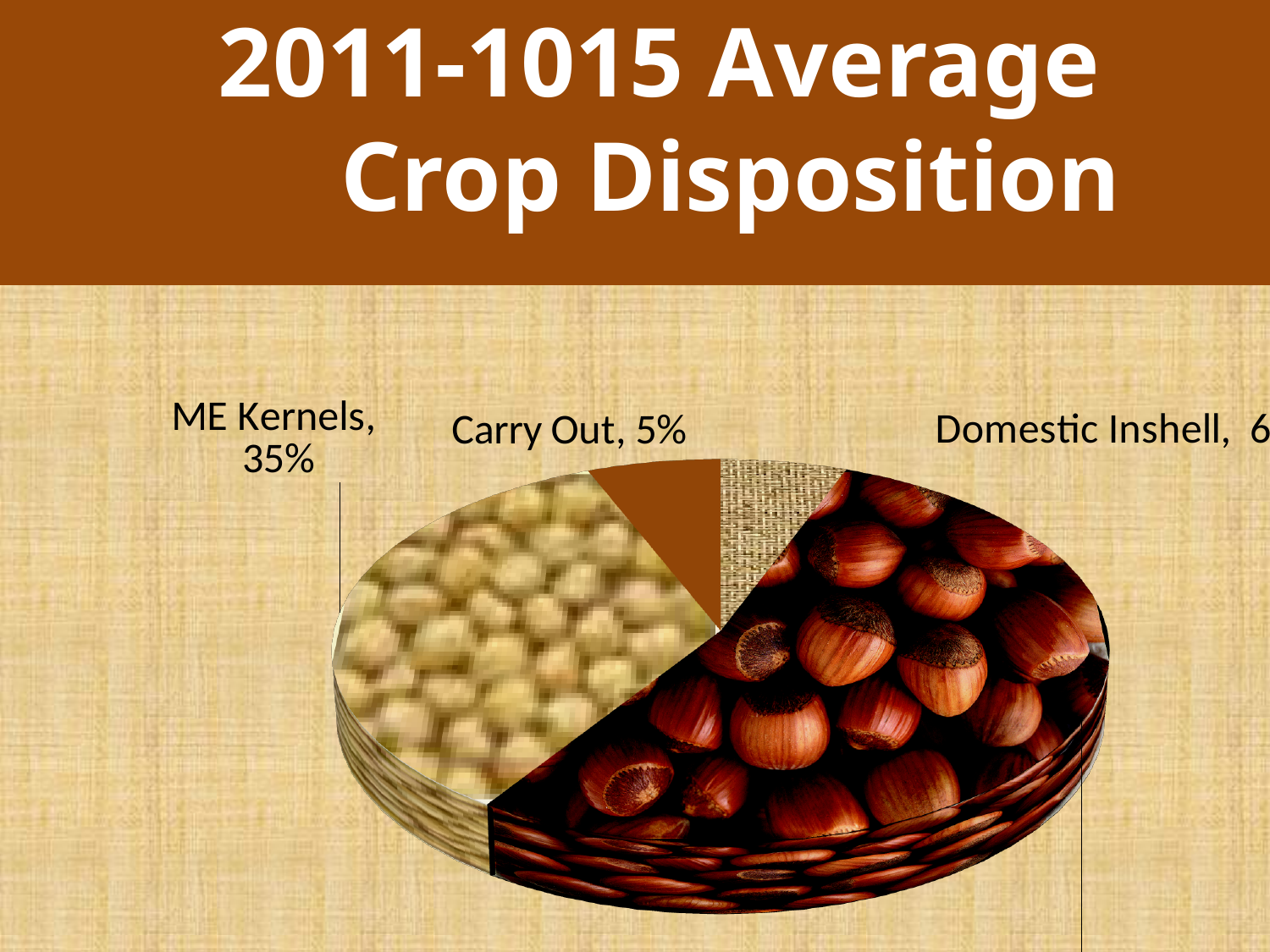
What kind of chart is shown on the slide? pie chart How many slices does the pie chart have? 4 What share of the pie is labelled for Carry Out? 5% Which is larger, the Domestic Inshell slice or the ME Kernels slice? ME Kernels Which is larger, the ME Kernels slice or the Carry Out slice? ME Kernels What is the difference in percentage points between the ME Kernels slice and the Carry Out slice? 30% What share of the pie is labelled for ME Kernels? 35% What is the title of the slide containing the pie chart? 2011-1015 Average Crop Disposition